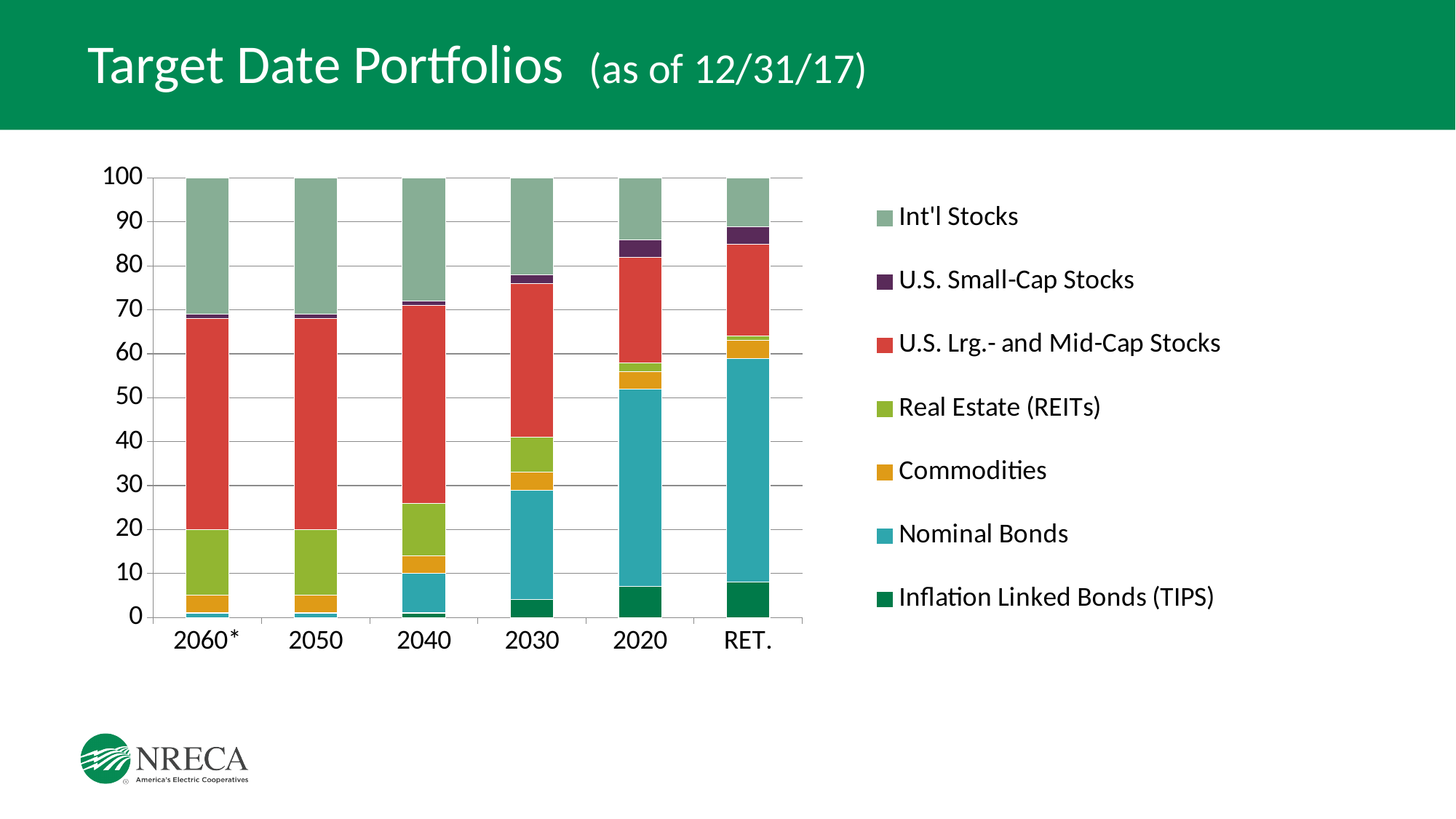
How many series does the legend list? 7 What is the title of the slide containing the chart? Target Date Portfolios (as of 12/31/17) What is the total height of the stacked bar for 2050? 100 Which is larger, the Int'l Stocks segment for 2060* or for RET.? 2060* What kind of chart is shown on the slide? Stacked bar chart What is the total height of the stacked bar for RET.? 100 Does the Nominal Bonds segment rise or fall moving from 2060* to RET. along the x axis? Rise Is the Int'l Stocks segment for RET. greater or less than 20? less Which portfolio has the largest Nominal Bonds segment? RET. How many portfolios (categories) are shown along the x axis? 6 Is the Nominal Bonds segment for 2020 greater or less than 30? greater Which is larger, the Nominal Bonds segment for 2030 or for 2020? 2020